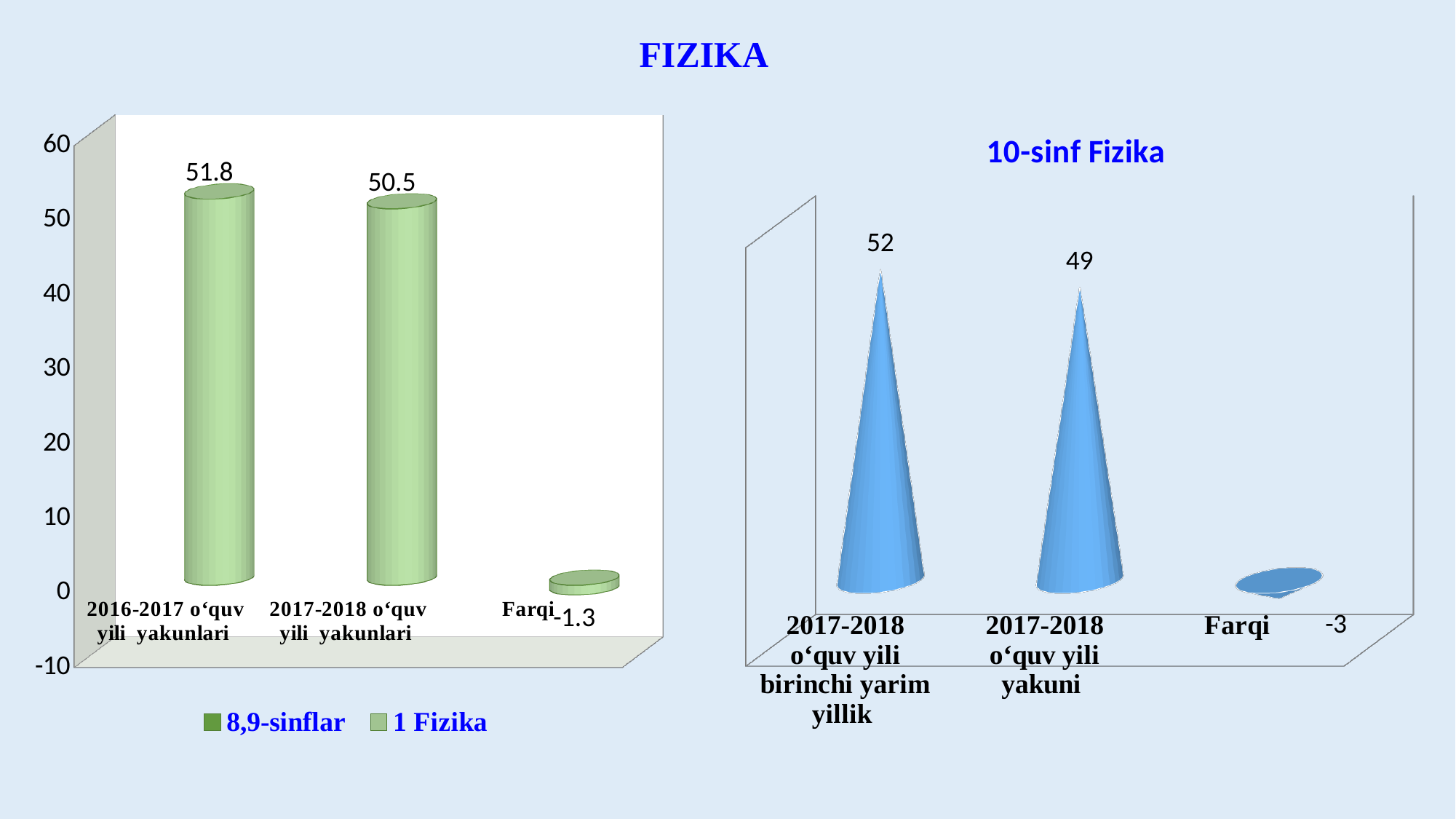
How many entries does the legend of the left chart list? 2 In the left chart, what is the difference between the 2016-2017 and 2017-2018 values? 1.3 In the left chart, what is the value for 2016-2017 o‘quv yili yakunlari? 51.8 What kind of chart is the left chart? Bar chart In the left chart, which category has the highest value? 2016-2017 o‘quv yili yakunlari In the 10-sinf Fizika chart, what is the value for 2017-2018 o‘quv yili yakuni? 49 How many categories are shown in the 10-sinf Fizika chart? 3 In the left chart, what is the value for 2017-2018 o‘quv yili yakunlari? 50.5 In the 10-sinf Fizika chart, what is the value for 2017-2018 o‘quv yili birinchi yarim yillik? 52 In the left chart, what is the value labelled Farqi? -1.3 In the 10-sinf Fizika chart, which is larger: the birinchi yarim yillik value or the yakuni value? birinchi yarim yillik In the 10-sinf Fizika chart, what is the value labelled Farqi? -3